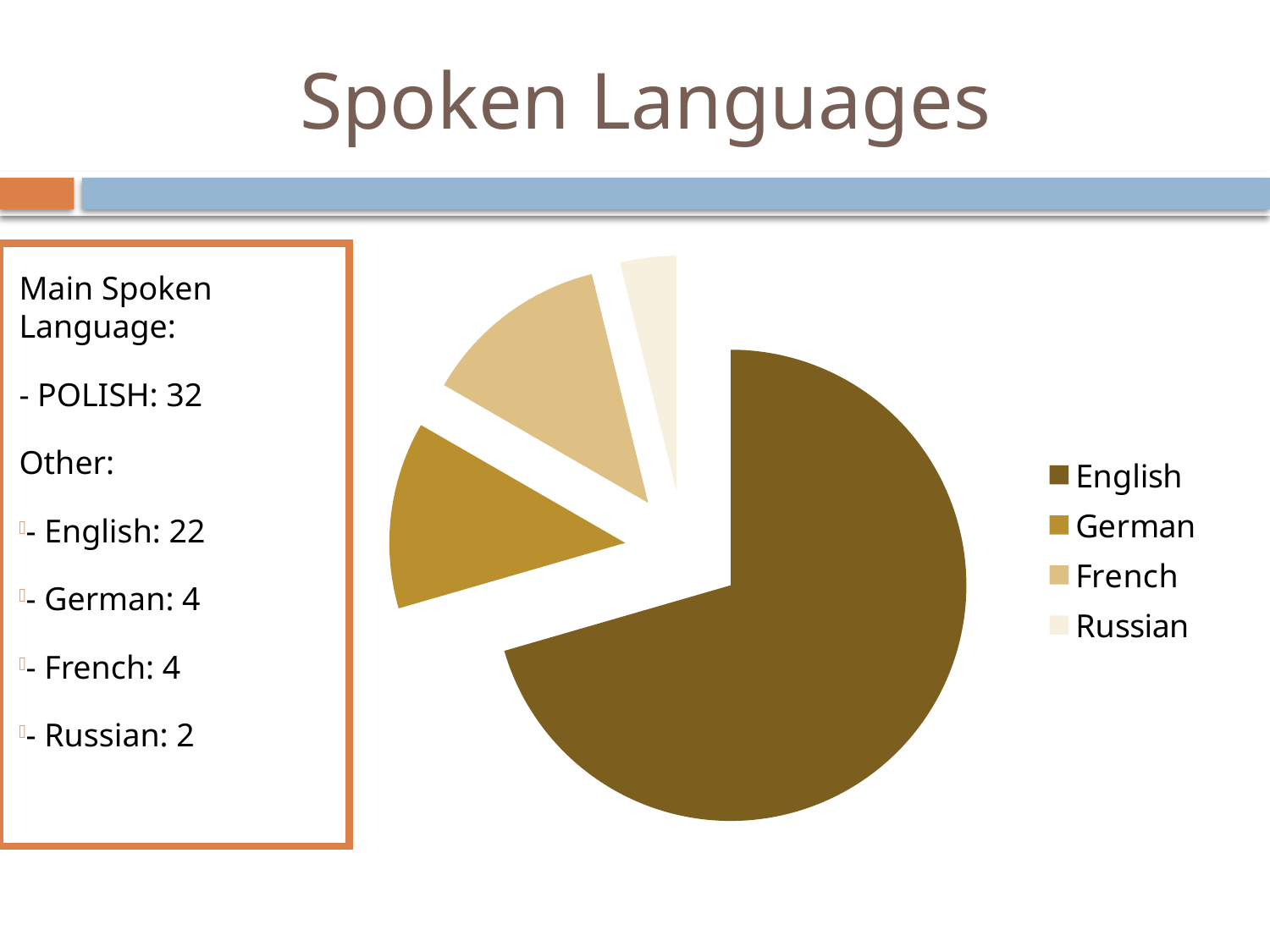
What is the difference between the number of English speakers and German speakers listed on the slide? 18 How many slices does the pie chart have? 4 Which language has the largest slice in the pie chart? English According to the slide, how many speakers does Russian have? 2 Which language has the smallest slice in the pie chart? Russian How many entries does the legend of the pie chart list? 4 What kind of chart is shown on the slide? pie chart What is the title of the slide containing the pie chart? Spoken Languages Is the slice for English larger or smaller than the slice for German? larger According to the slide, how many speakers does English have? 22 Is the slice for French larger or smaller than the slice for Russian? larger